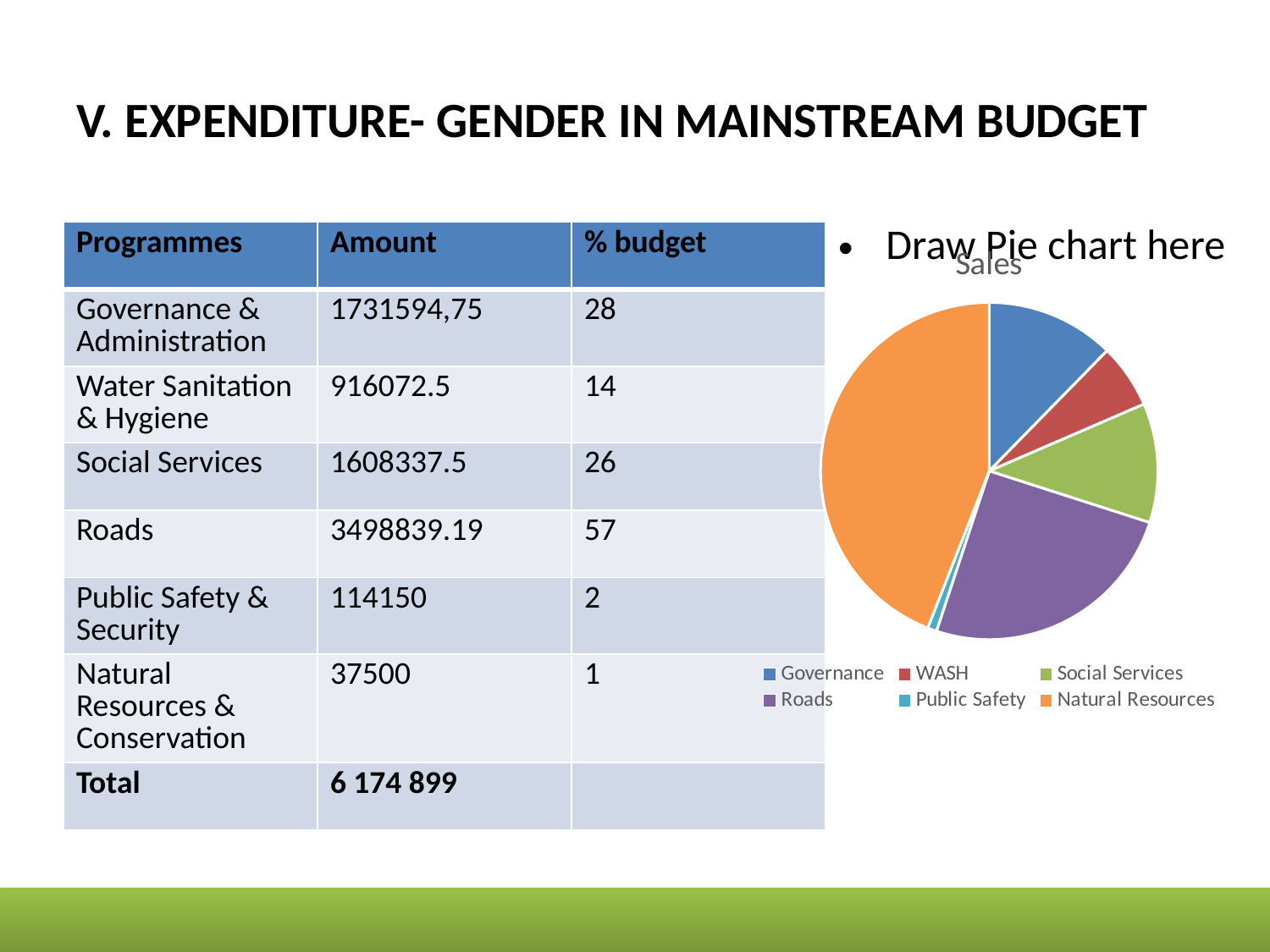
In the pie chart, which slice is larger, Social Services or Public Safety? Social Services In the pie chart, which slice is larger, Natural Resources or Governance? Natural Resources What kind of chart is shown on the slide? pie chart Which category has the largest slice in the pie chart? Natural Resources What colour is the Roads slice in the pie chart? purple What is the title of the pie chart? Sales In the pie chart, which slice is larger, Natural Resources or Roads? Natural Resources How many categories does the pie chart's legend list? 6 Which category has the smallest slice in the pie chart? Public Safety